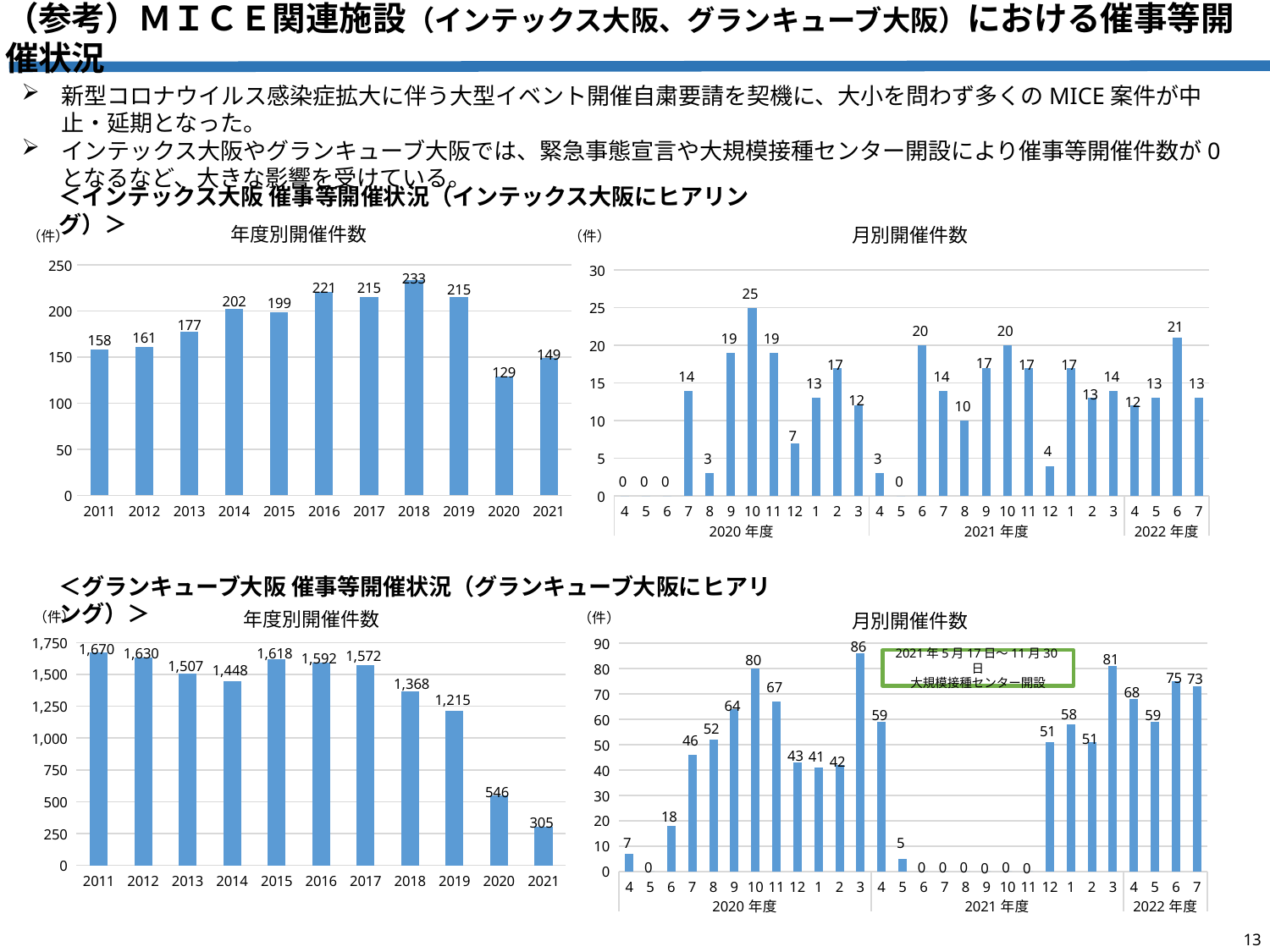
In the bottom-left chart (グランキューブ大阪 年度別開催件数), what is the value for 2011? 1,670 In the top-left chart (インテックス大阪 年度別開催件数), which year has the lowest value? 2020 In the top-left chart (インテックス大阪 年度別開催件数), what is the value for 2018? 233 What type of chart is the bottom-right chart (グランキューブ大阪 月別開催件数)? Bar chart In the top-left chart (インテックス大阪 年度別開催件数), what is the difference between the values for 2019 and 2020? 86 How many years are shown in the top-left chart (インテックス大阪 年度別開催件数)? 11 In the bottom-left chart (グランキューブ大阪 年度別開催件数), what is the difference between the values for 2020 and 2021? 241 In the bottom-right chart (グランキューブ大阪 月別開催件数), how many months of 2021年度 have a value of 0? 6 In the bottom-right chart (グランキューブ大阪 月別開催件数), what is the value for month 3 of 2020年度? 86 In the top-right chart (インテックス大阪 月別開催件数), what is the value for month 10 of 2020年度? 25 In the top-right chart (インテックス大阪 月別開催件数), which month of 2022年度 has the highest value? 6 In the bottom-left chart (グランキューブ大阪 年度別開催件数), which is larger, the value for 2015 or the value for 2016? 2015